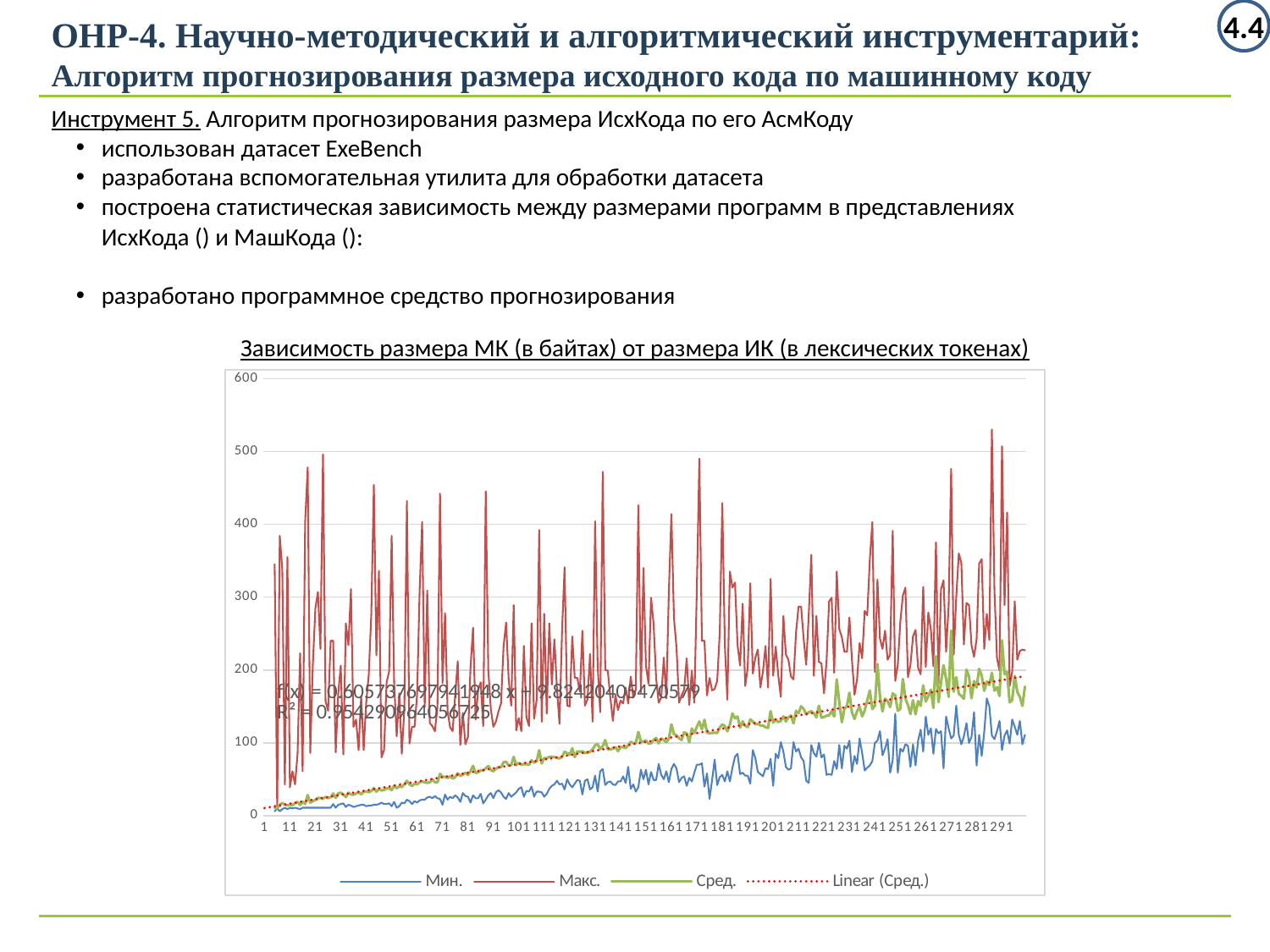
Which series has the highest values on the chart? Макс. Which series are listed in the chart legend? Мин., Макс., Сред., Linear (Сред.) Is the value of the Мин. series at x = 291 greater or less than 200? less Does the Мин. series rise or fall overall along the x axis? rises Is the highest peak of the Макс. series greater or less than 500? greater Which series has the lowest values on the chart? Мин. How many entries does the chart legend list? 4 Does the Сред. series rise or fall as the x axis increases? rises What kind of chart is shown on the slide? line chart What is the title of the chart? Зависимость размера МК (в байтах) от размера ИК (в лексических токенах) Which series is generally larger, Макс. or Мин.? Макс.